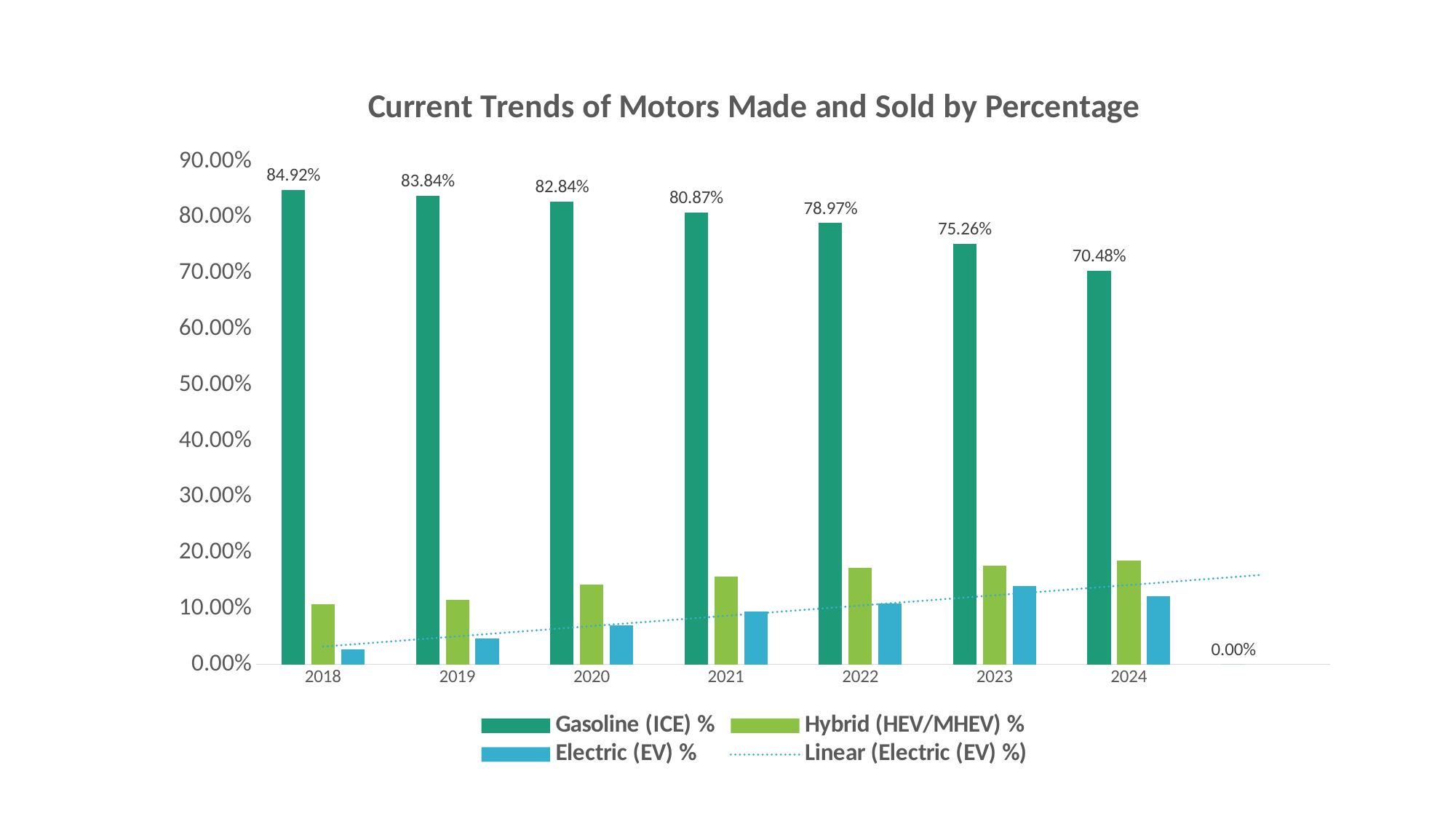
Is the Hybrid (HEV/MHEV) % value for 2024 greater or less than 20.00%? less What is the difference between the Gasoline (ICE) % values for 2018 and 2024? 14.44% What kind of chart is shown on the slide? Bar chart What is the Gasoline (ICE) % value for 2021? 80.87% Which is larger, the Gasoline (ICE) % value for 2022 or for 2023? 2022 How many series does the legend list? 4 What is the Gasoline (ICE) % value for 2018? 84.92% What is the Gasoline (ICE) % value for 2024? 70.48% In which year is the Gasoline (ICE) % value lowest? 2024 Do the Gasoline (ICE) % values rise or fall from 2018 to 2024? Fall Is the Electric (EV) % value for 2023 greater or less than 10.00%? greater In which year is the Gasoline (ICE) % value highest? 2018